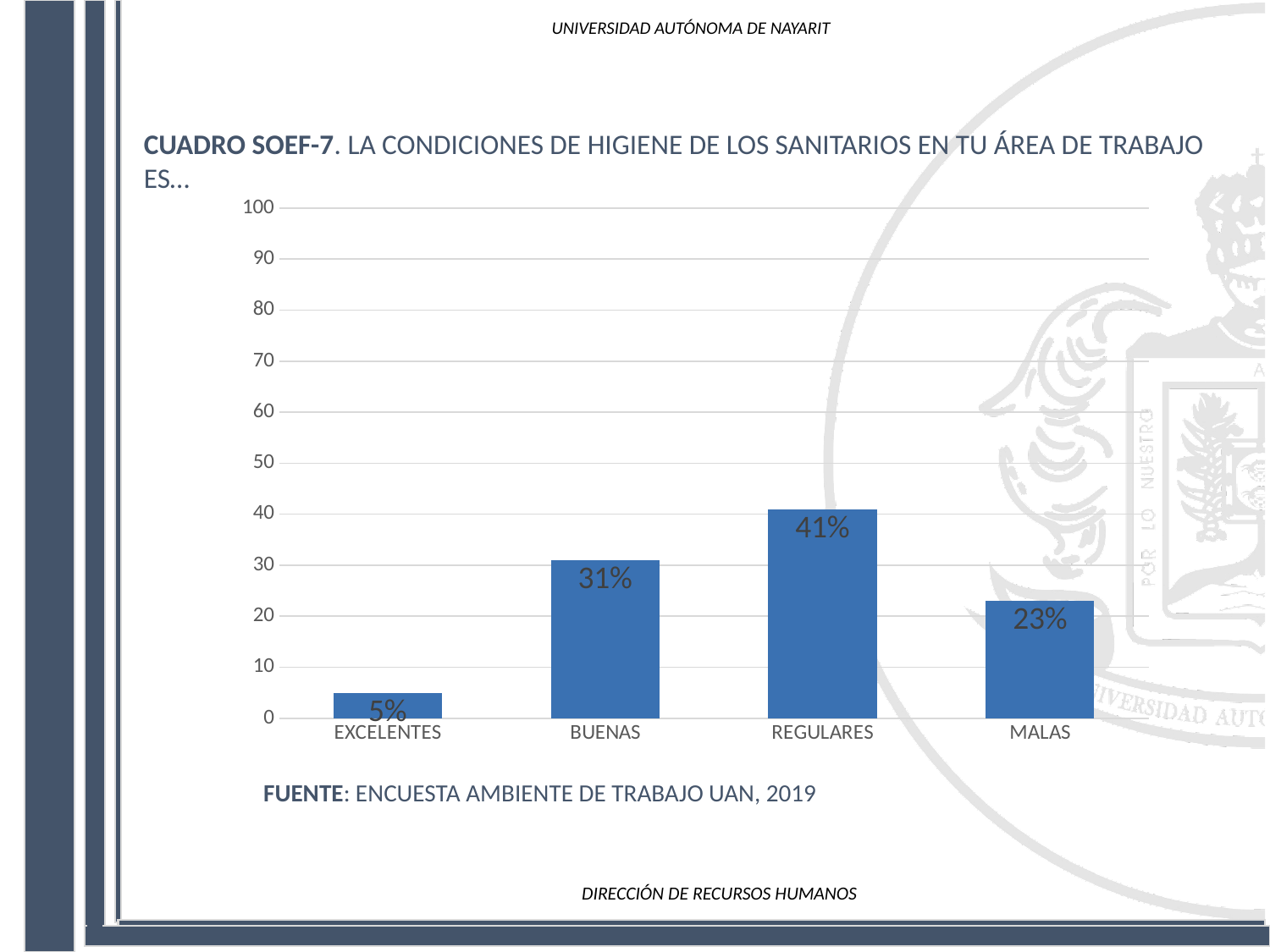
What is the difference between the values for REGULARES and BUENAS? 10% How many categories are shown on the x axis? 4 Is the value for MALAS greater or less than 30? less Which category has the highest value? REGULARES Which is larger, the value for BUENAS or the value for MALAS? BUENAS What source is cited below the chart? ENCUESTA AMBIENTE DE TRABAJO UAN, 2019 What is the value for EXCELENTES? 5% Which category has the lowest value? EXCELENTES What is the value for REGULARES? 41% What is the maximum value shown on the y axis? 100 What kind of chart is shown on the slide? bar chart What is the value for MALAS? 23%